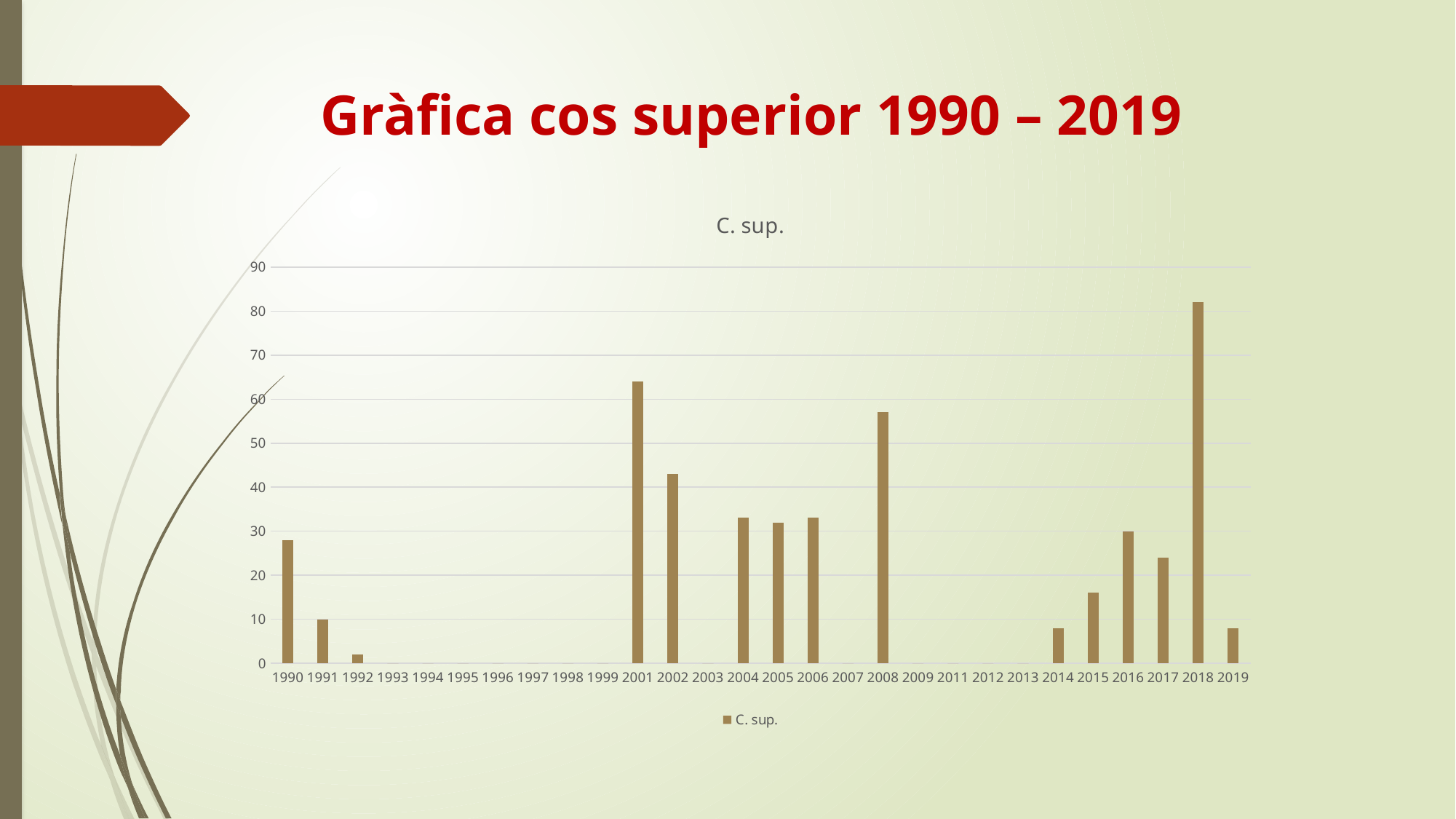
Is the value for 2018 greater or less than 80? greater What kind of chart is shown on the slide? bar chart Is the value for 2002 greater or less than 40? greater Which is larger, the value for 2017 or the value for 2002? 2002 Which year has the highest value? 2018 Is the value for 2001 greater or less than 60? greater How many series does the legend list? 1 Which is larger, the value for 2001 or the value for 2008? 2001 How many year categories are shown on the x axis? 28 What is the title of the chart? C. sup.